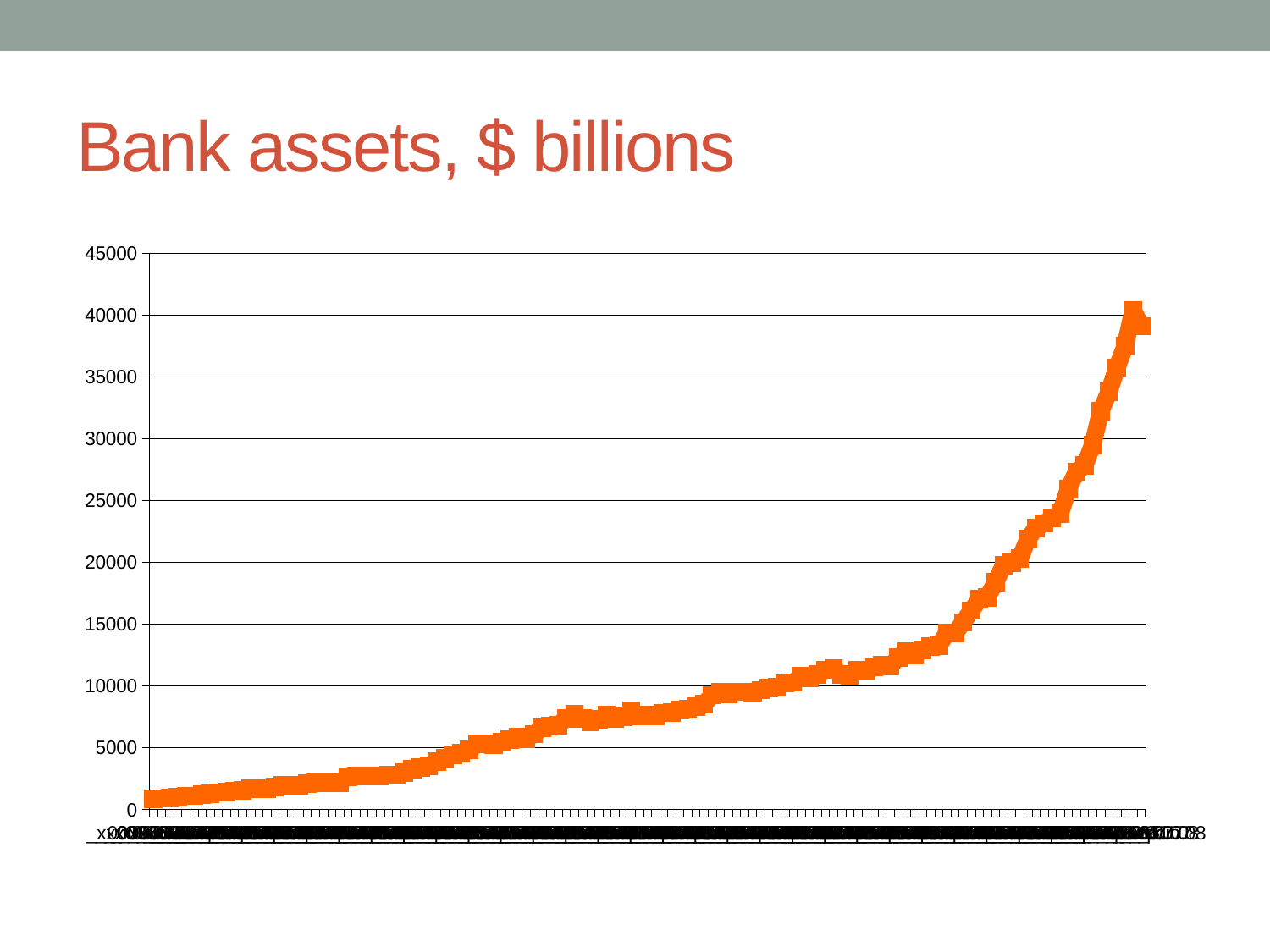
Is the peak of the line reached near the left end or the right end of the x axis? right end Is the highest value reached by the line greater or less than 35000? greater Do the values generally rise or fall from left to right along the x axis? rise What is the title of the chart? Bank assets, $ billions Is the value at the left-hand start of the line greater or less than 5000? less What colour is the plotted line? orange Is the value at the midpoint of the x axis greater or less than 15000? less What is the highest tick value shown on the y axis? 45000 Is the lowest point of the line at the left end or the right end of the x axis? left end What kind of chart is shown on the slide? line chart